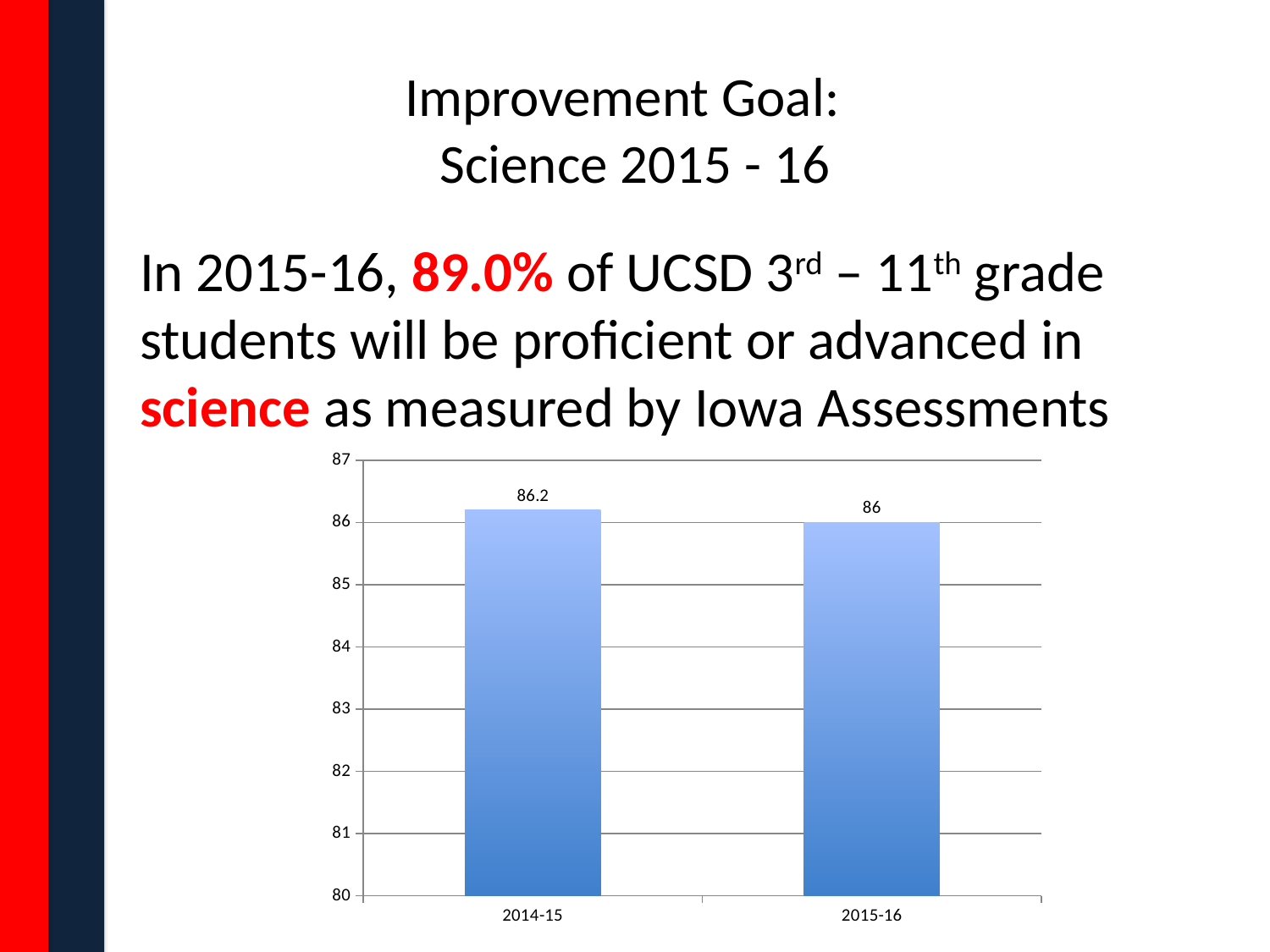
How many categories are shown on the x axis? 2 Which category has the lowest value? 2015-16 Is the value for 2015-16 greater or less than 85? greater What is the value for 2015-16? 86 What is the value for 2014-15? 86.2 What is the lowest value shown on the y axis? 80 Which is larger, the value for 2014-15 or the value for 2015-16? 2014-15 Is the value for 2014-15 greater or less than 87? less Which category has the highest value? 2014-15 What is the difference between the values for 2014-15 and 2015-16? 0.2 Do the values rise or fall from 2014-15 to 2015-16? fall What kind of chart is shown on the slide? bar chart